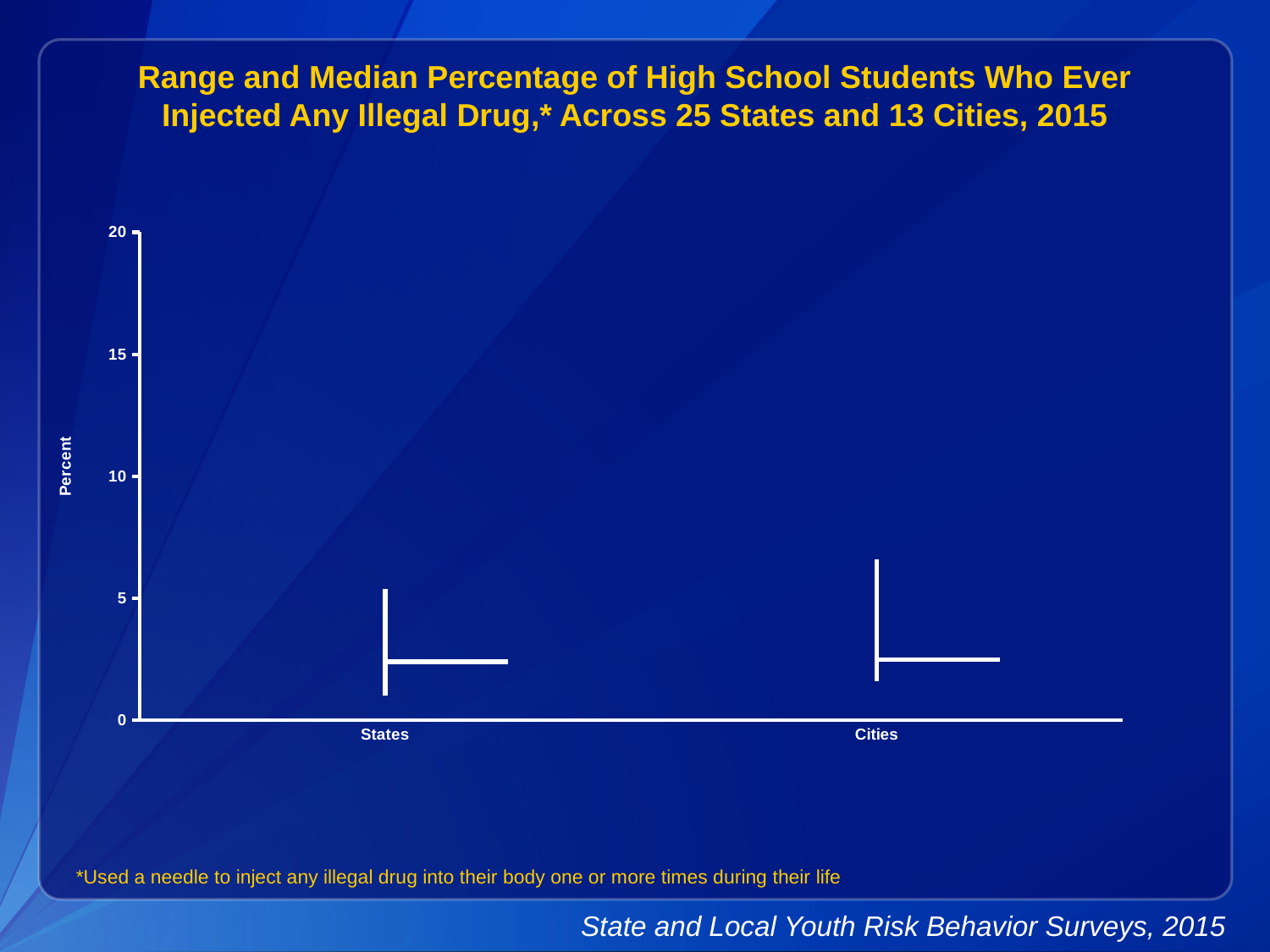
What is the label of the y axis? Percent Is the top of the range for Cities greater or less than 10? less Is the top of the range for States greater or less than 10? less Is the median value for States greater or less than 5? less How many categories are shown on the x axis of the chart? 2 What are the two categories shown on the x axis? States and Cities Which category has the higher top of its range, States or Cities? Cities What is the highest value shown on the y axis? 20